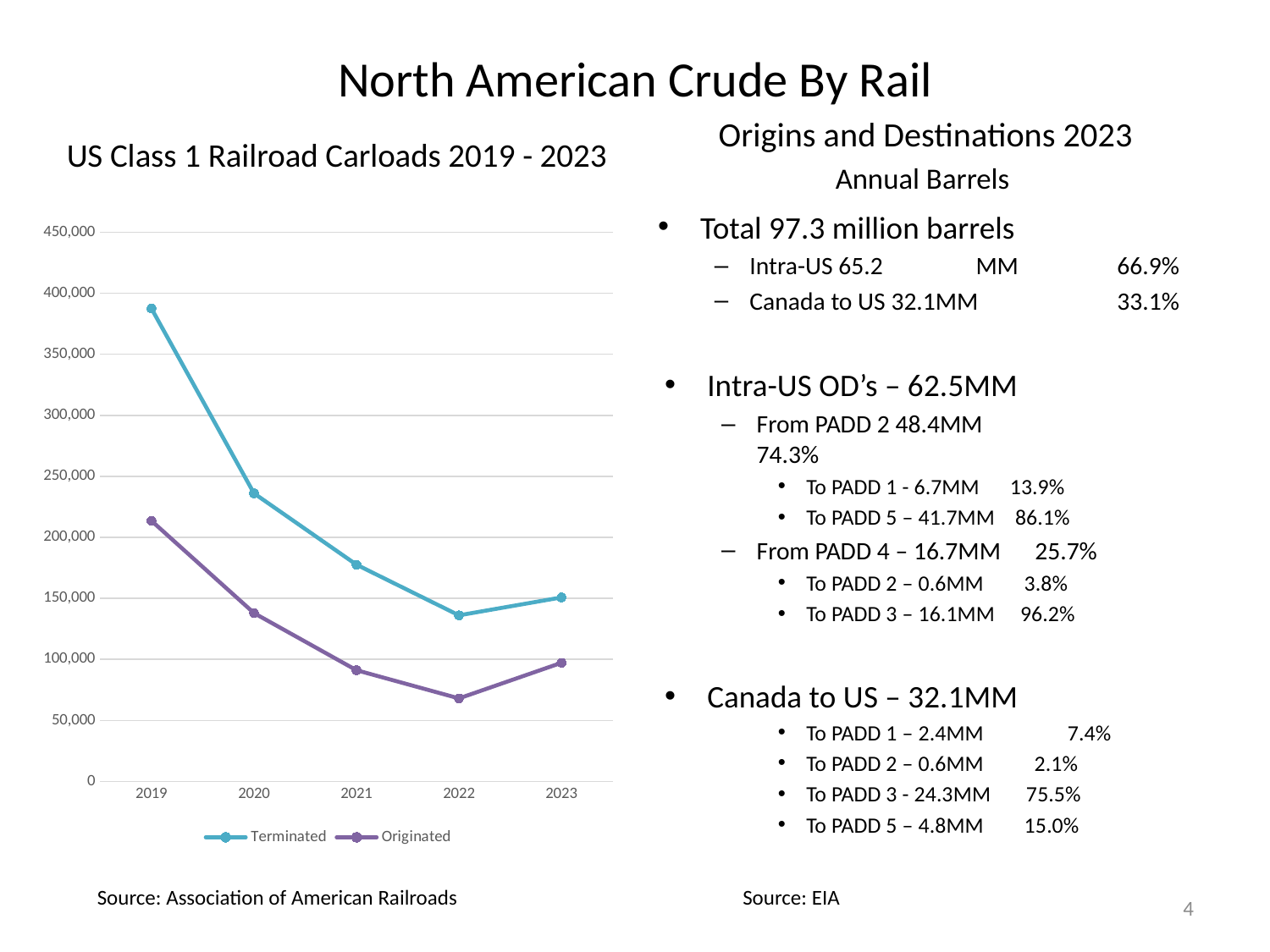
Is the Originated value for 2022 greater or less than 100,000? less Do the Terminated carloads rise or fall from 2019 to 2022? fall What are the two series named in the chart legend? Terminated and Originated Is the Terminated value for 2019 greater or less than 350,000? greater In 2019, which series has the larger value, Terminated or Originated? Terminated What kind of chart is shown on the slide? Line chart In which year is the Terminated series at its highest? 2019 In which year is the Originated series at its lowest? 2022 In which year is the Terminated series at its lowest? 2022 How many series does the chart legend list? 2 Is the Terminated value for 2020 greater or less than 250,000? less How many years are plotted along the x axis of the chart? 5